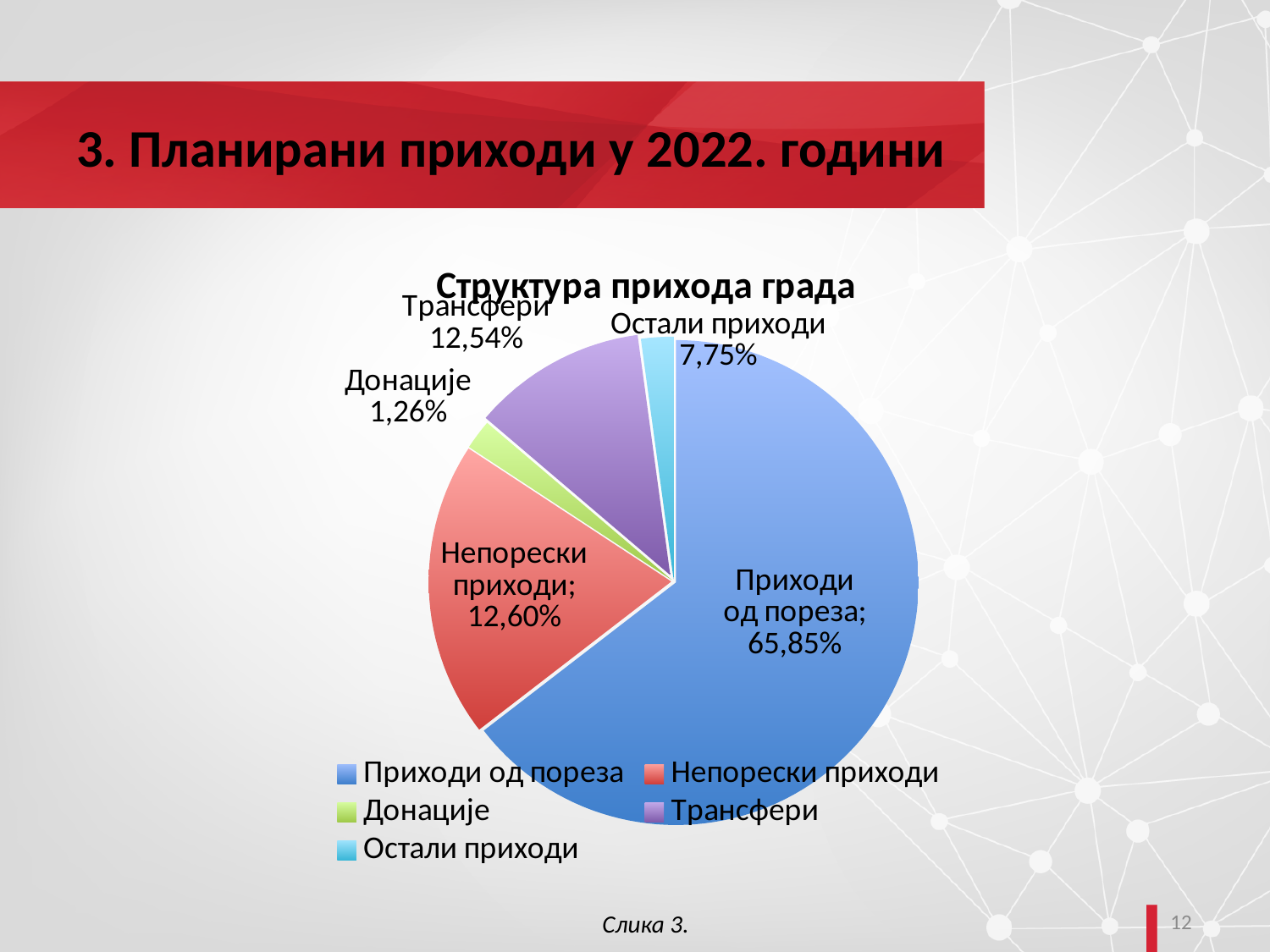
What is the difference between the values for Приходи од пореза and Непорески приходи? 53,25% Which category has the largest slice of the pie? Приходи од пореза What is the value shown for Остали приходи? 7,75% How many categories does the pie chart have? 5 Which category has the smallest slice of the pie? Донације What is the title of the chart? Структура прихода града What kind of chart is shown on the slide? pie chart What is the value shown for Донације? 1,26% Which is larger, Остали приходи or Донације? Остали приходи What share of the pie is Приходи од пореза? 65,85% What is the value shown for Трансфери? 12,54% What is the value shown for Непорески приходи? 12,60%